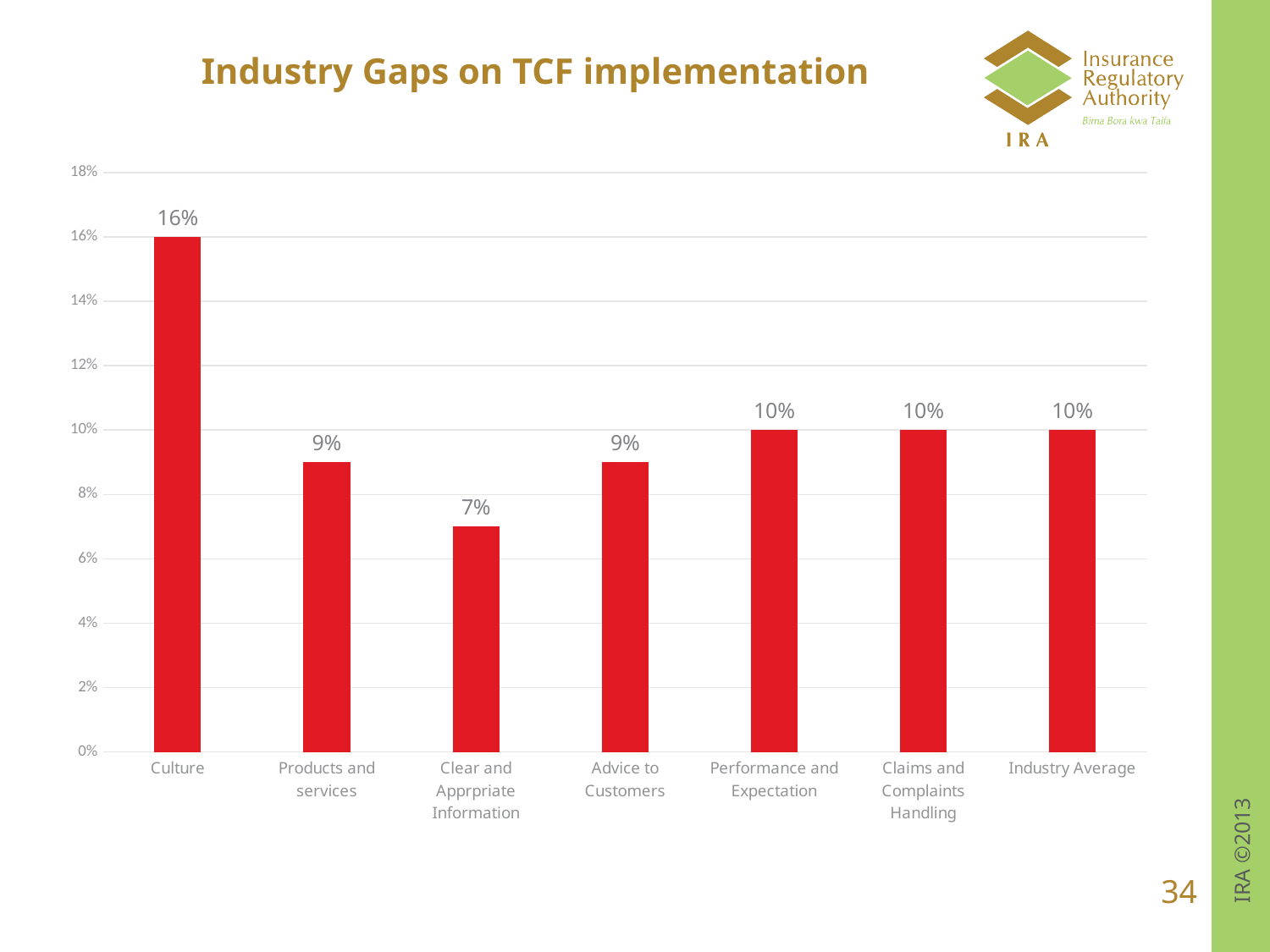
Which category has the highest value? Culture What is the value for Industry Average? 10% Is the value for Advice to Customers greater or less than 10%? less What is the title of the slide? Industry Gaps on TCF implementation What is the value for Culture? 16% Which is larger, the value for Products and services or the value for Performance and Expectation? Performance and Expectation What kind of chart is shown on the slide? bar chart How many categories are shown on the x axis? 7 What is the difference between the values for Culture and Industry Average? 6% Which category has the lowest value? Clear and Apprpriate Information What colour are the bars in the chart? red What is the value for Clear and Apprpriate Information? 7%